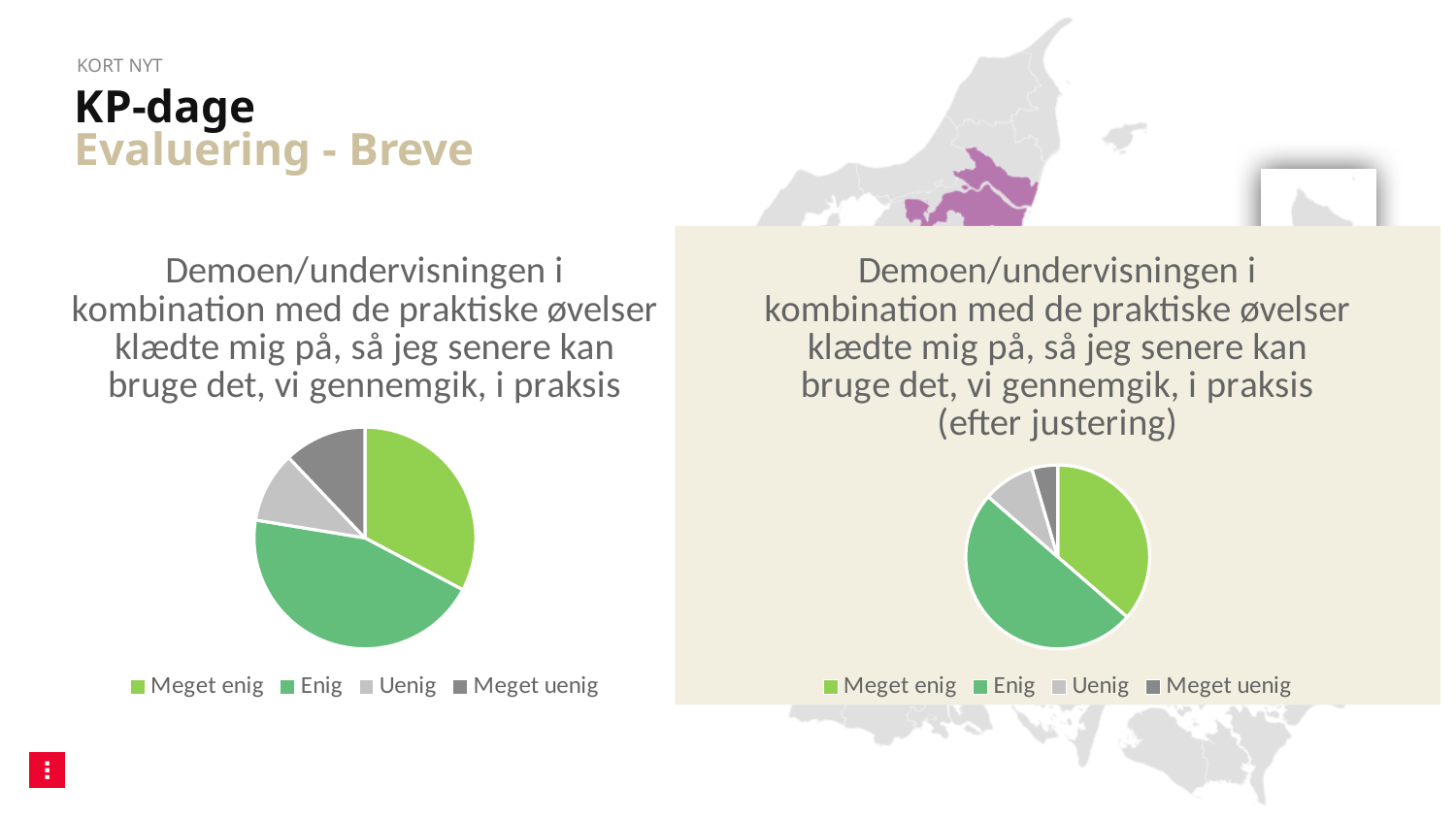
What kind of chart is the right chart (efter justering)? Pie chart In the right pie chart (efter justering), which slice is larger: Enig or Meget enig? Enig In the right pie chart (efter justering), which slice is larger: Uenig or Meget uenig? Uenig In the left pie chart, which category has the largest slice? Enig In the left pie chart, which category is shown in dark grey? Meget uenig How many slices does the right pie chart (efter justering) have? 4 In the left pie chart, which slice is larger: Meget enig or Uenig? Meget enig In the right pie chart (efter justering), which category has the largest slice? Enig How many entries does the legend of the left pie chart list? 4 In the right pie chart (efter justering), which category has the smallest slice? Meget uenig What kind of chart is the left chart titled "Demoen/undervisningen i kombination med de praktiske øvelser klædte mig på, så jeg senere kan bruge det, vi gennemgik, i praksis"? Pie chart What are the four legend entries of the right pie chart (efter justering)? Meget enig, Enig, Uenig, Meget uenig